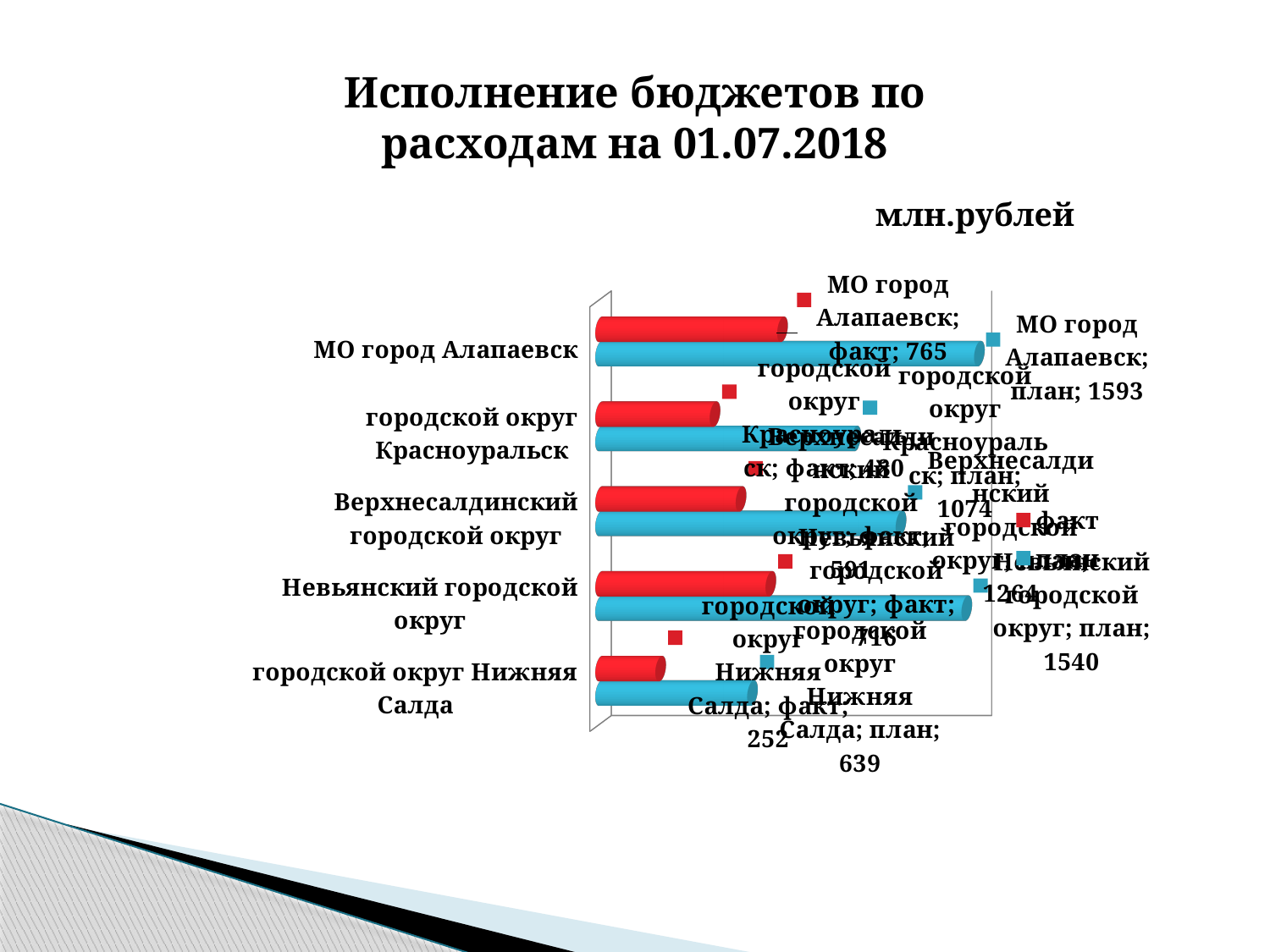
What kind of chart is shown on the slide? bar chart Which is larger: the факт value for МО город Алапаевск or the факт value for Невьянский городской округ? МО город Алапаевск In what units are the values in the chart expressed, according to the slide? млн.рублей What is the план (plan) value for МО город Алапаевск? 1593 How many municipalities (categories) are shown in the chart? 5 What is the план value for Невьянский городской округ? 1540 Which municipality has the lowest план value? городской округ Нижняя Салда Which municipality has the highest план value? МО город Алапаевск What is the план value for городской округ Красноуральск? 1074 What is the факт value for городской округ Нижняя Салда? 252 What is the difference between the план and факт values for МО город Алапаевск? 828 What is the факт (actual) value for МО город Алапаевск? 765